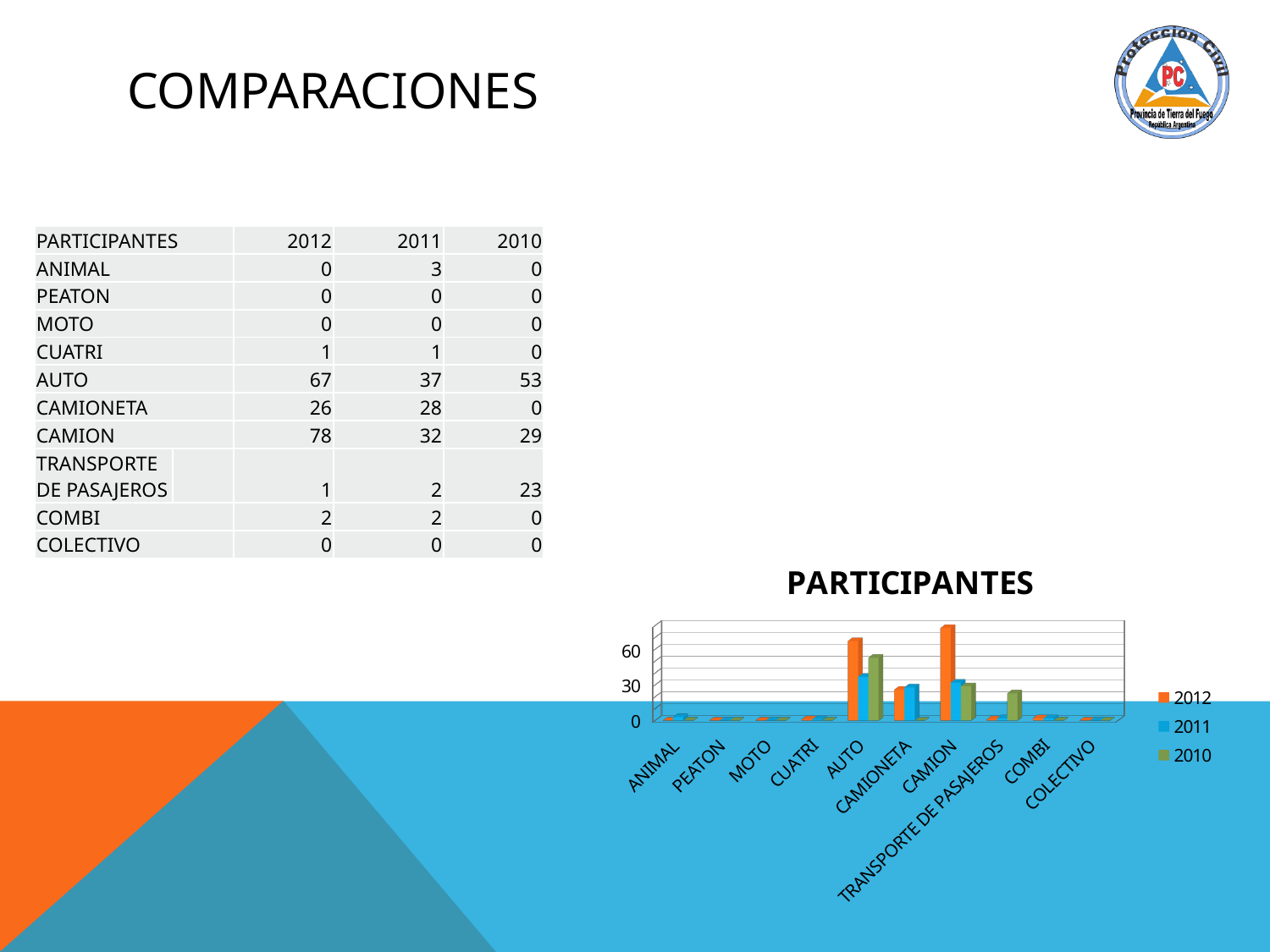
What is the value for AUTO in 2012? 67 How many categories are shown along the x axis of the PARTICIPANTES chart? 10 What is the value for CAMION in 2011? 32 Which is larger in 2010, the value for AUTO or the value for CAMION? AUTO How many series does the legend of the PARTICIPANTES chart list? 3 What is the difference between the 2012 and 2011 values for AUTO? 30 Is the 2012 value for CAMION greater or less than 60? greater What kind of chart is shown on the slide? bar chart What is the title of the chart? PARTICIPANTES Which category has the highest value for 2012 in the PARTICIPANTES chart? CAMION Which category has the highest value for 2010 in the PARTICIPANTES chart? AUTO What is the value for TRANSPORTE DE PASAJEROS in 2010? 23